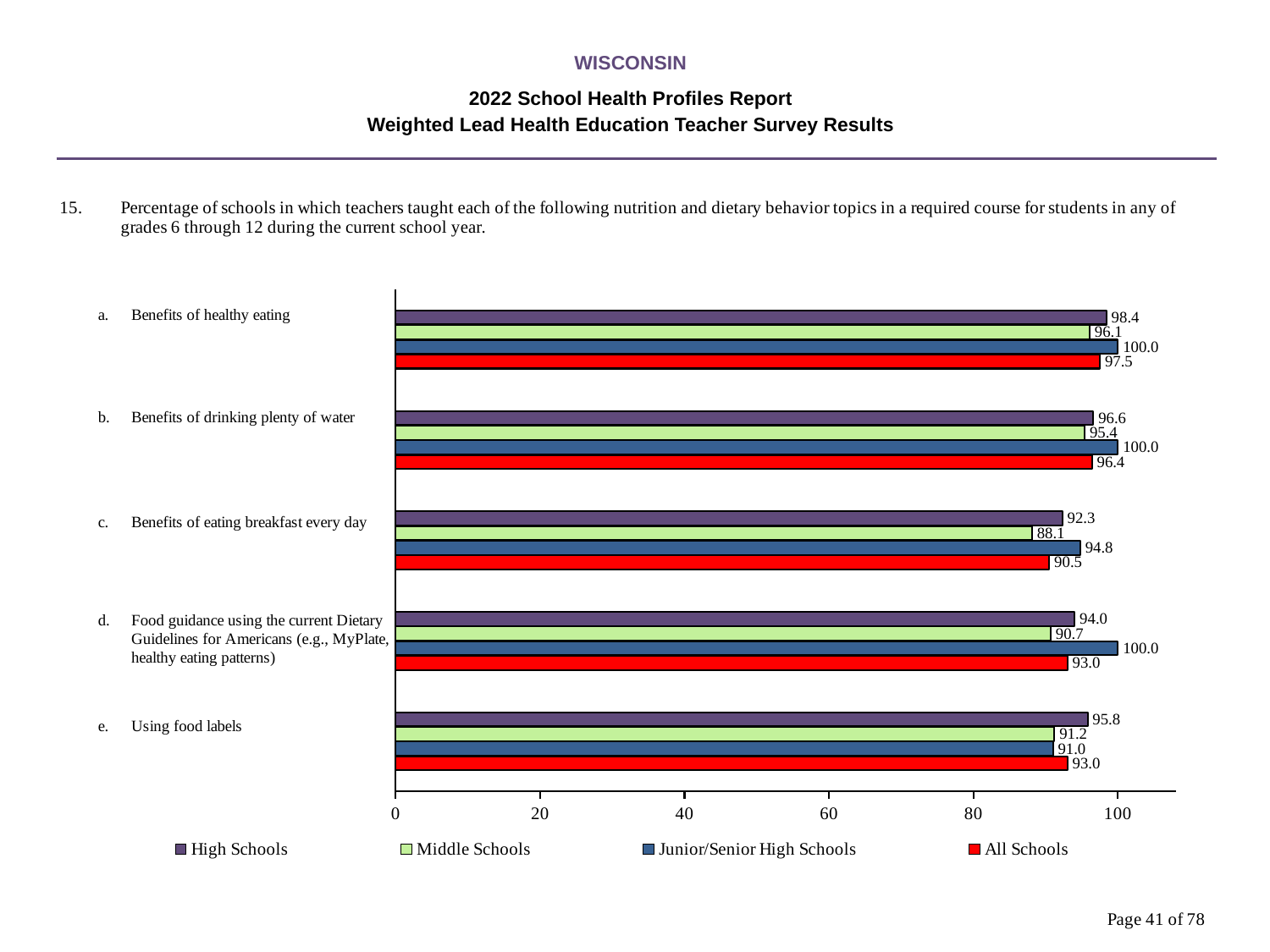
How many series does the legend list? 4 How many topics (categories) are shown in the chart? 5 Which topic has the lowest value for Middle Schools? Benefits of eating breakfast every day Is the value for Middle Schools for 'Benefits of eating breakfast every day' greater or less than 90? less What kind of chart is shown on the slide? Bar chart What is the difference between the High Schools and Middle Schools values for 'Using food labels'? 4.6 Which topic has the highest value for High Schools? Benefits of healthy eating Which is larger for 'Benefits of eating breakfast every day': the High Schools value or the Junior/Senior High Schools value? Junior/Senior High Schools What is the value for High Schools for 'Benefits of healthy eating'? 98.4 What is the value for Junior/Senior High Schools for 'Food guidance using the current Dietary Guidelines for Americans (e.g., MyPlate, healthy eating patterns)'? 100.0 What is the value for All Schools for 'Using food labels'? 93.0 What is the value for Middle Schools for 'Benefits of eating breakfast every day'? 88.1